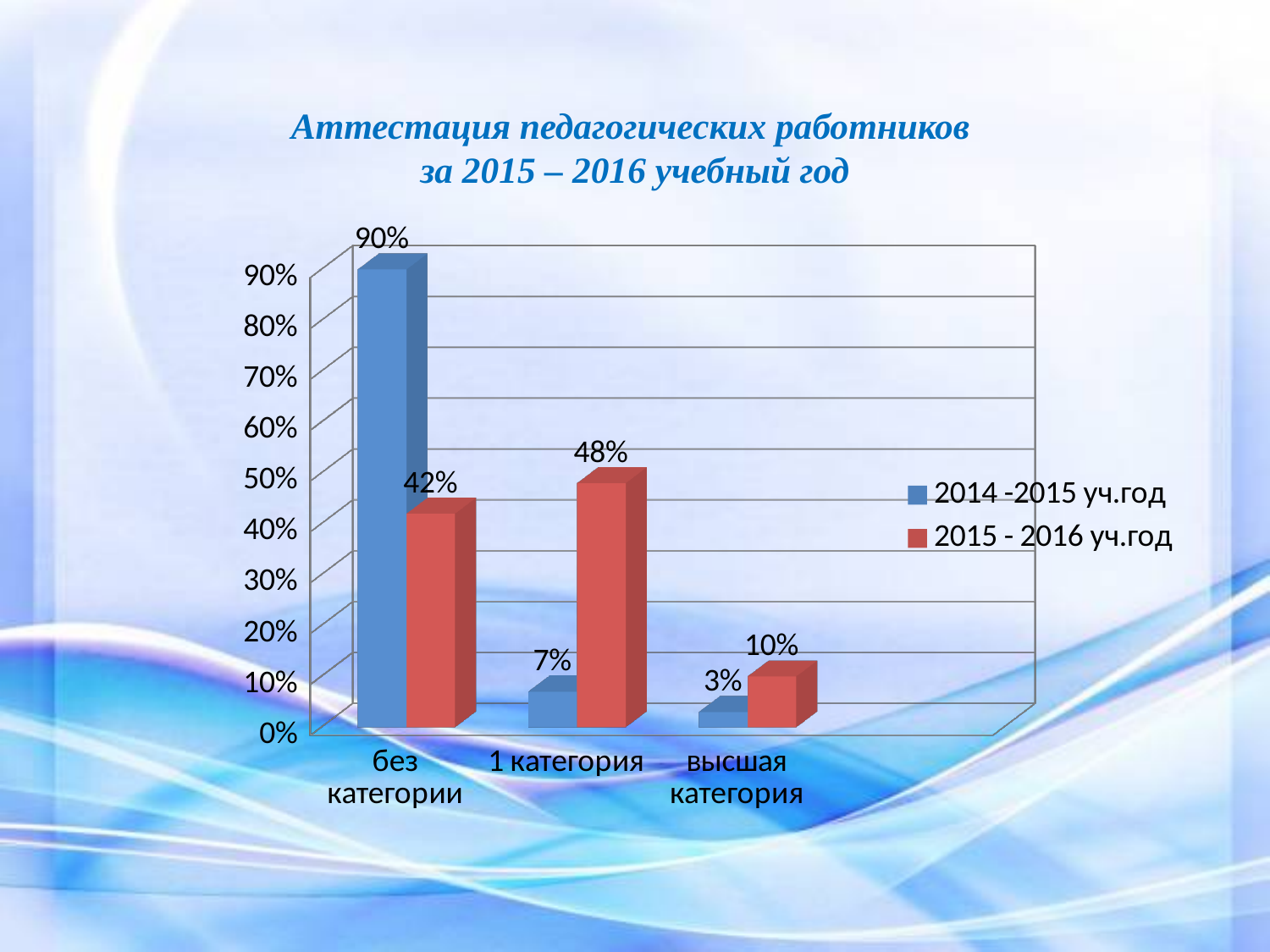
What is the value for "1 категория" in the 2015 - 2016 уч.год series? 48% How many series does the legend list? 2 What is the value for "высшая категория" in the 2015 - 2016 уч.год series? 10% Which category has the highest value in the 2015 - 2016 уч.год series? 1 категория How many categories are shown on the x axis? 3 What kind of chart is shown on the slide? bar chart Which is larger for "1 категория": the 2014 -2015 уч.год value or the 2015 - 2016 уч.год value? 2015 - 2016 уч.год Which category has the lowest value in the 2014 -2015 уч.год series? высшая категория What is the difference between the 2014 -2015 уч.год and 2015 - 2016 уч.год values for "без категории"? 48% What is the value for "без категории" in the 2014 -2015 уч.год series? 90% What is the value for "высшая категория" in the 2014 -2015 уч.год series? 3% Which colour represents the 2015 - 2016 уч.год series? red